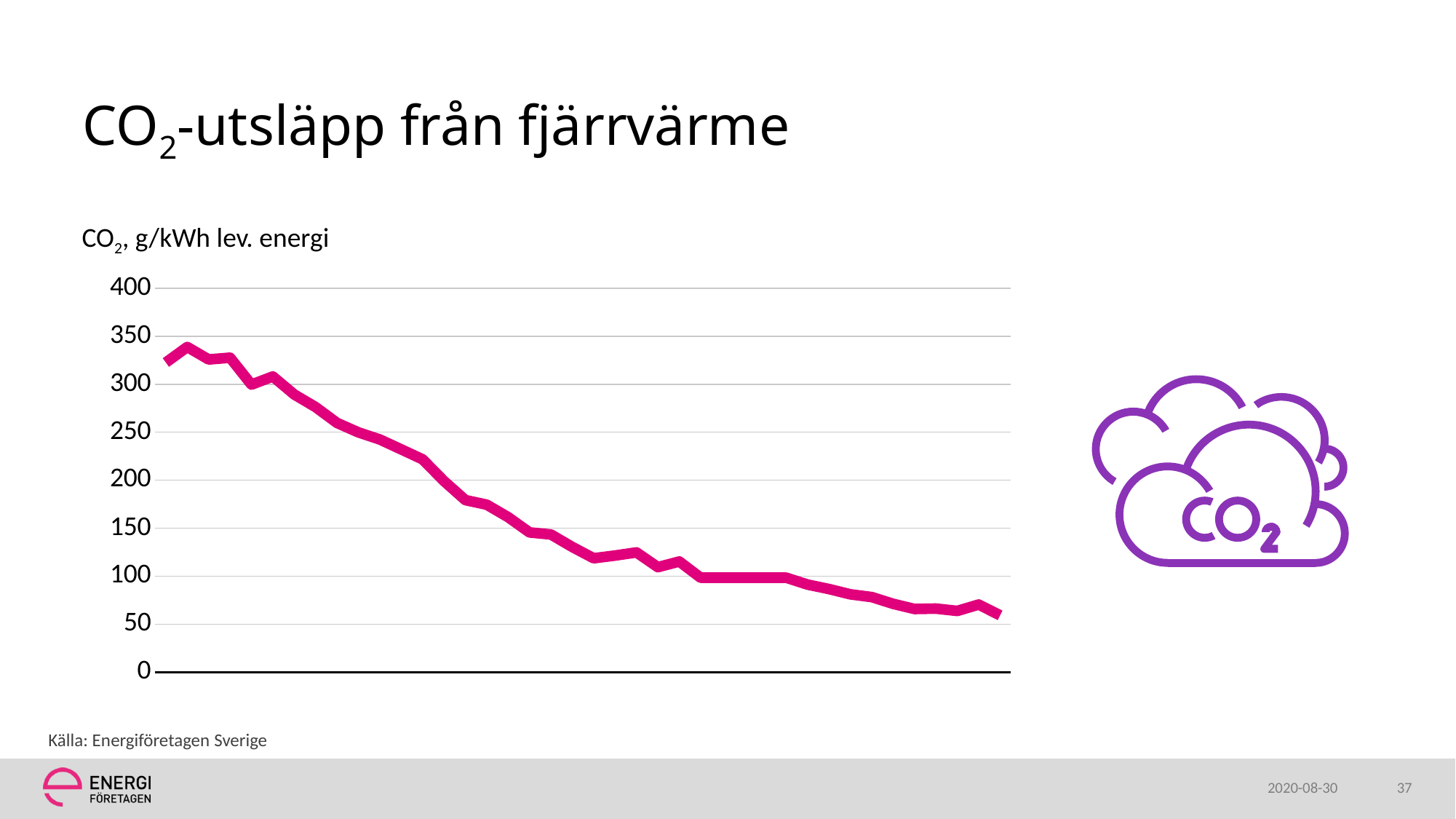
Is the value at the right end (end) of the line greater or less than 100? less Do the CO2 emission values rise or fall along the x axis overall? fall Is the value at the end of the line greater or less than 150? less Is the lowest point of the line greater or less than 50? greater What is the highest value shown on the y axis? 400 What kind of chart is shown on the slide? line chart What unit is given for the y axis of the chart? CO2, g/kWh lev. energi